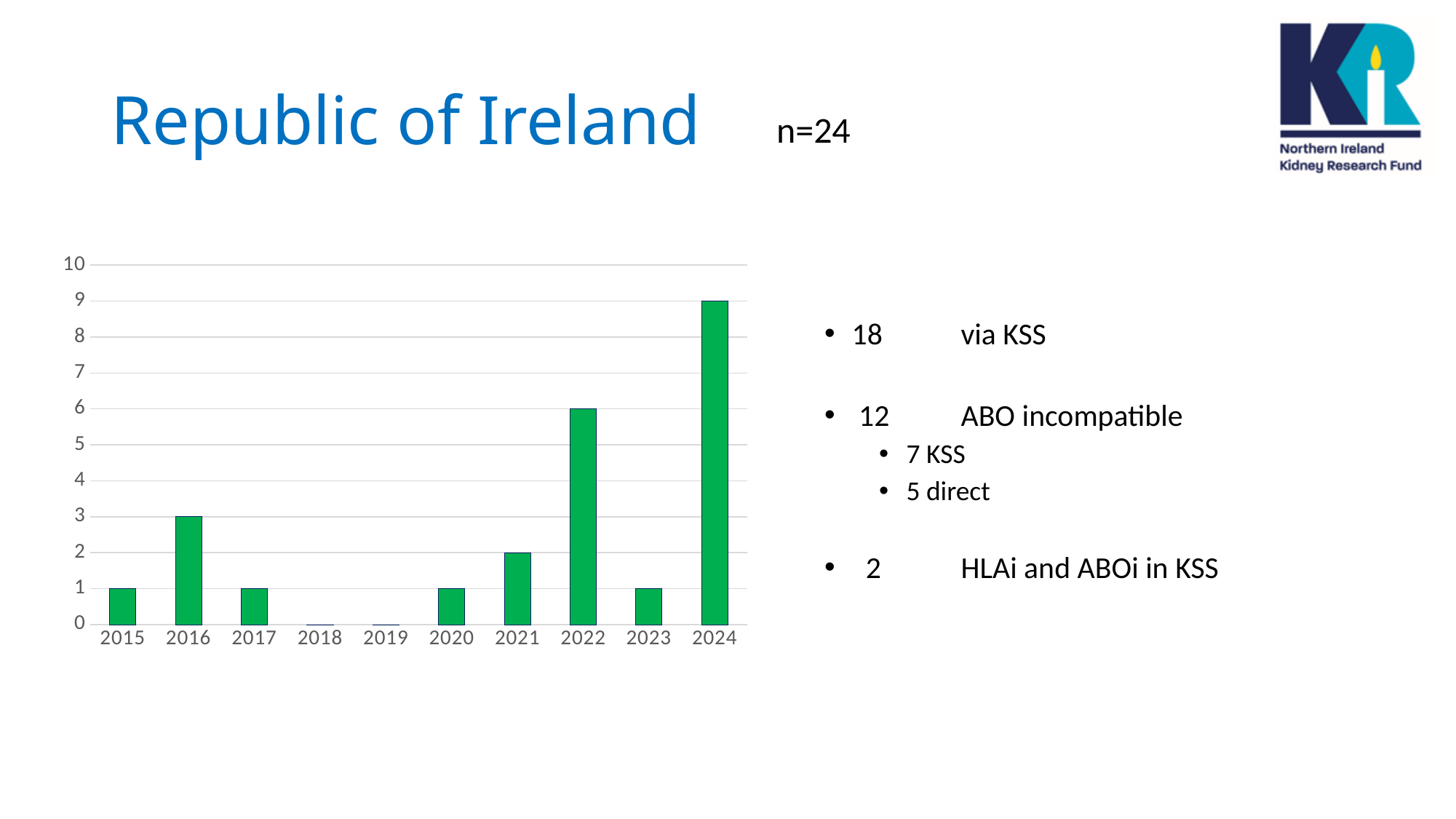
Which is larger in the chart, the value for 2022 or the value for 2023? 2022 Which years in the chart have a value of 0? 2018 and 2019 What is the difference between the values for 2024 and 2022 in the chart? 3 How many years are shown on the x axis of the chart? 10 What is the value for 2021 in the chart? 2 What is the title of the slide containing the chart? Republic of Ireland What is the value for 2016 in the chart? 3 What is the value for 2022 in the chart? 6 Which year has the highest bar in the chart? 2024 Is the value for 2024 greater or less than 5? greater What is the value for 2024 in the chart? 9 What type of chart is shown on the slide? bar chart